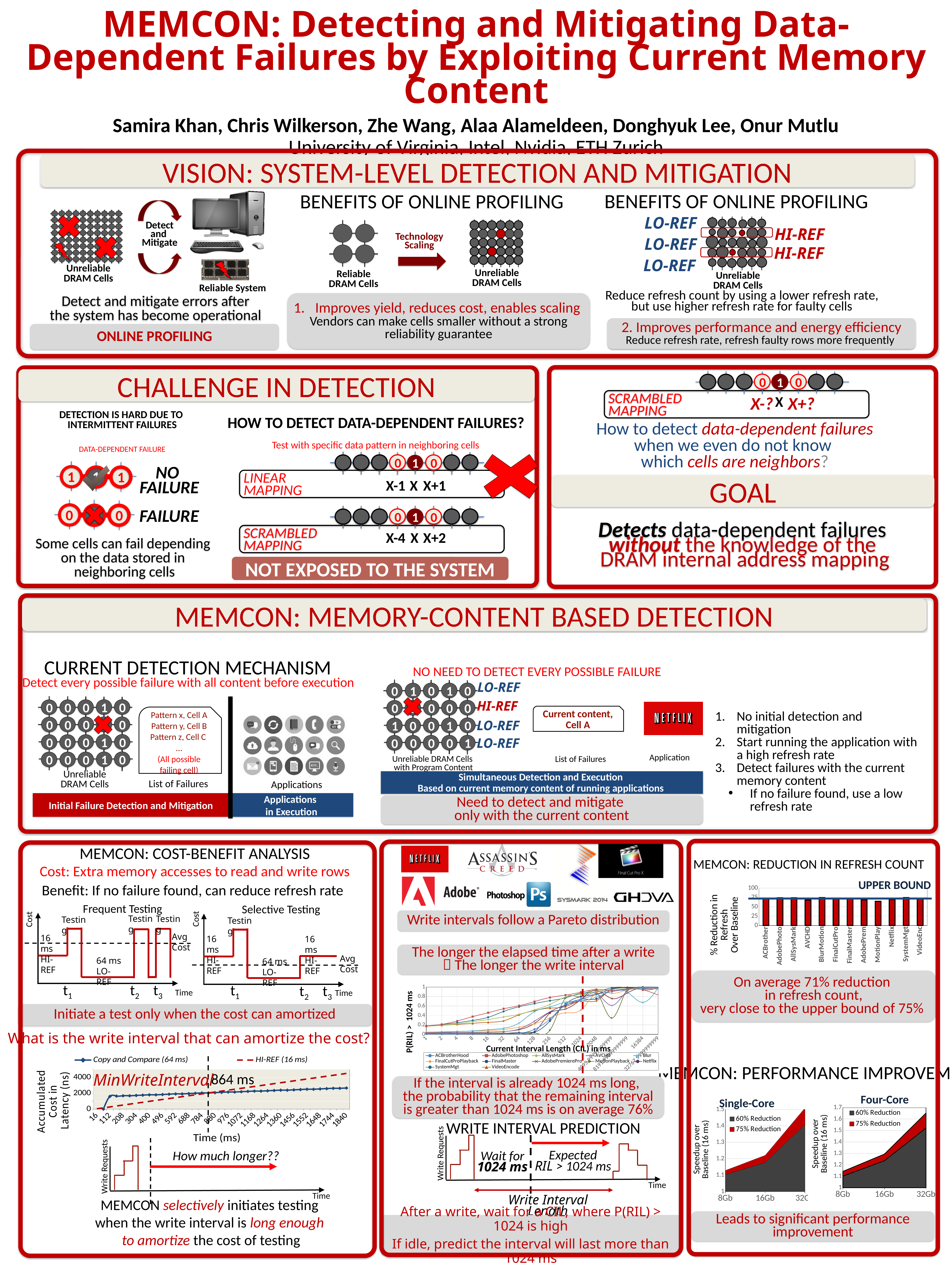
How many series does the legend list in the "Single-Core" speedup chart? 2 In the "Four-Core" speedup chart, does the speedup rise or fall as memory size increases from 8Gb to 32Gb? rise How many series does the legend list in the "Accumulated Cost in Latency (ns)" chart in the cost-benefit analysis section? 2 What kind of chart is the "MEMCON: REDUCTION IN REFRESH COUNT" chart? bar chart How many series does the legend list in the line chart of P(RIL) > 1024 ms versus Current Interval Length (CIL)? 12 In the "MEMCON: REDUCTION IN REFRESH COUNT" chart, is the value for Netflix greater or less than 50? greater How many application categories are shown on the x axis of the "MEMCON: REDUCTION IN REFRESH COUNT" chart? 12 In the "MEMCON: REDUCTION IN REFRESH COUNT" chart, is the value for AVCHD greater or less than 25? greater How many memory-size categories are on the x axis of the "Single-Core" speedup chart? 3 What is the label of the horizontal line drawn across the top of the bars in the "MEMCON: REDUCTION IN REFRESH COUNT" chart? UPPER BOUND What kind of chart is the chart of P(RIL) > 1024 ms versus Current Interval Length (CIL) in ms? line chart What are the two legend entries in the "Accumulated Cost in Latency (ns)" chart? Copy and Compare (64 ms); HI-REF (16 ms)